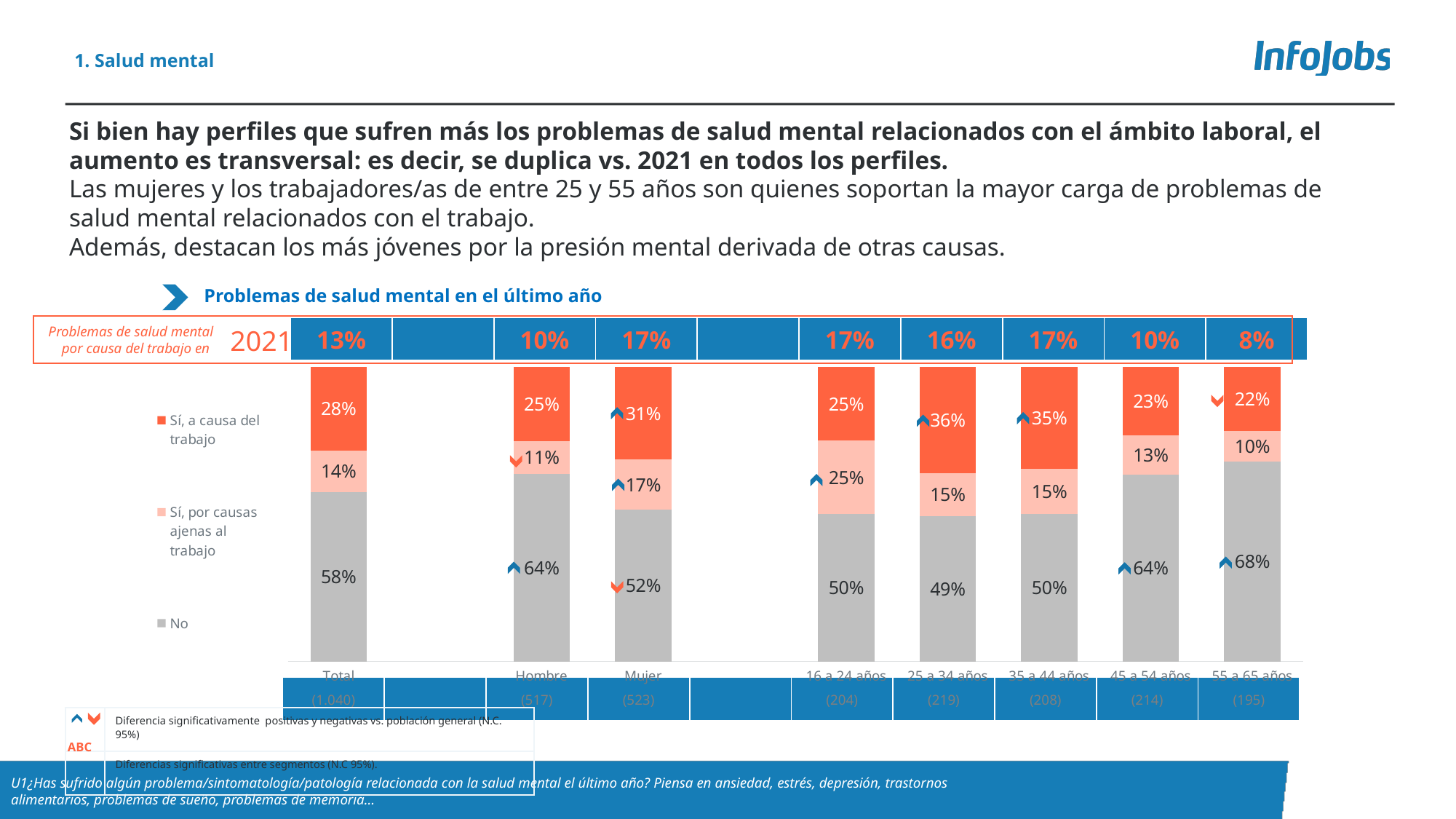
Which category has the highest value for 'Sí, a causa del trabajo'? 25 a 34 años How many categories are plotted along the x axis? 8 Which category has the lowest value for 'No'? 25 a 34 años What is the value of 'No' for 55 a 65 años? 68% What is the sample size shown below the bar for Mujer? (523) What is the value of 'Sí, a causa del trabajo' for Mujer? 31% What kind of chart is shown under the heading 'Problemas de salud mental en el último año'? Stacked bar chart What is the difference between the 'Sí, a causa del trabajo' values for Mujer and Hombre? 6% Which is larger, the 'No' value for Hombre or for Mujer? Hombre How many series does the legend list? 3 What is the value of 'Sí, por causas ajenas al trabajo' for 16 a 24 años? 25% What was the 2021 value of 'Problemas de salud mental por causa del trabajo' for Total, shown in the row above the bars? 13%